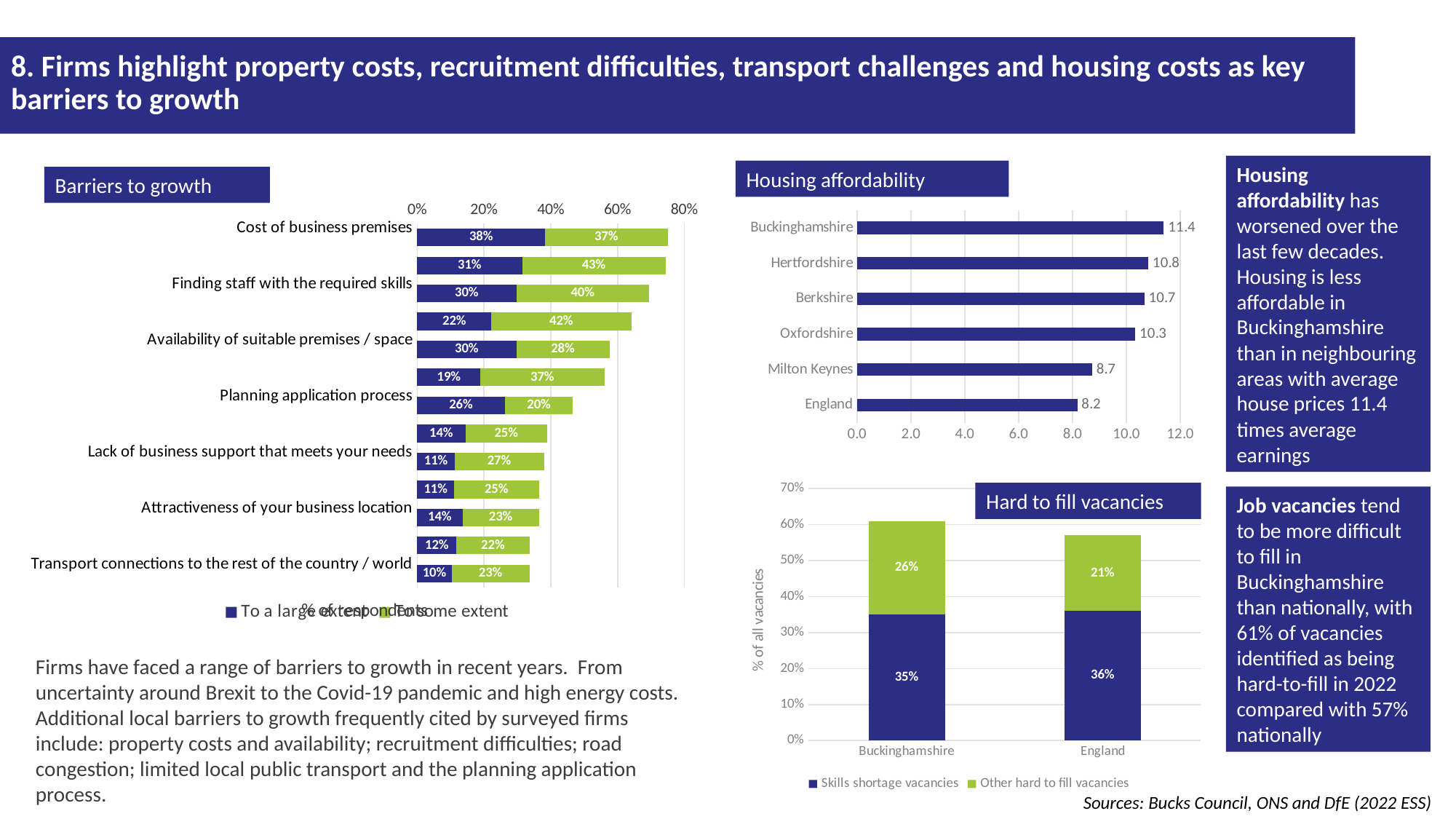
In the Housing affordability chart, which area has the highest value? Buckinghamshire In the Housing affordability chart, what is the value for Milton Keynes? 8.7 In the Hard to fill vacancies chart, what is the value for Skills shortage vacancies in England? 36% In the Housing affordability chart, what is the value for Buckinghamshire? 11.4 In the Hard to fill vacancies chart, what is the total of the stacked bar for Buckinghamshire? 61% In the Housing affordability chart, what is the difference between the values for Buckinghamshire and England? 3.2 In the Housing affordability chart, how many areas are shown? 6 In the Barriers to growth chart, what is the 'To a large extent' value for Cost of business premises? 38% In the Housing affordability chart, which is larger, the value for Oxfordshire or the value for Milton Keynes? Oxfordshire What kind of chart is the Barriers to growth chart? Stacked bar chart In the Housing affordability chart, which area has the lowest value? England In the Hard to fill vacancies chart, how many series does the legend list? 2